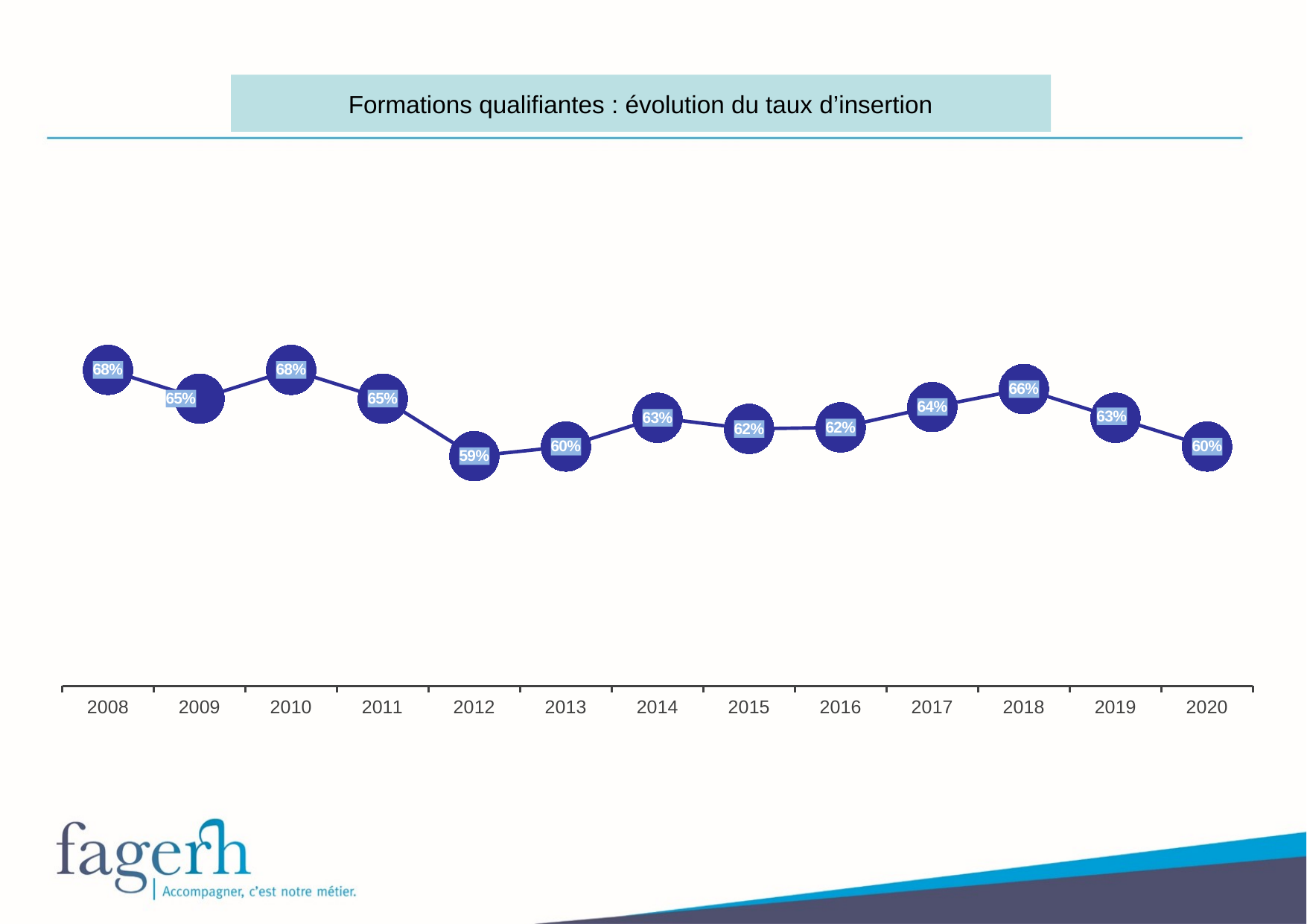
Do the values rise or fall from 2008 to 2012? Fall What is the difference between the values for 2018 and 2020? 6% What is the value plotted for 2014? 63% What is the value plotted for 2020? 60% What is the highest value shown on the chart? 68% What is the value plotted for 2018? 66% How many years are plotted on the chart? 13 What is the insertion rate shown for 2012? 59% Which year has the larger value, 2017 or 2019? 2017 What is the difference between the values for 2010 and 2012? 9% Which year has the lowest insertion rate? 2012 What kind of chart is shown on the slide? Line chart